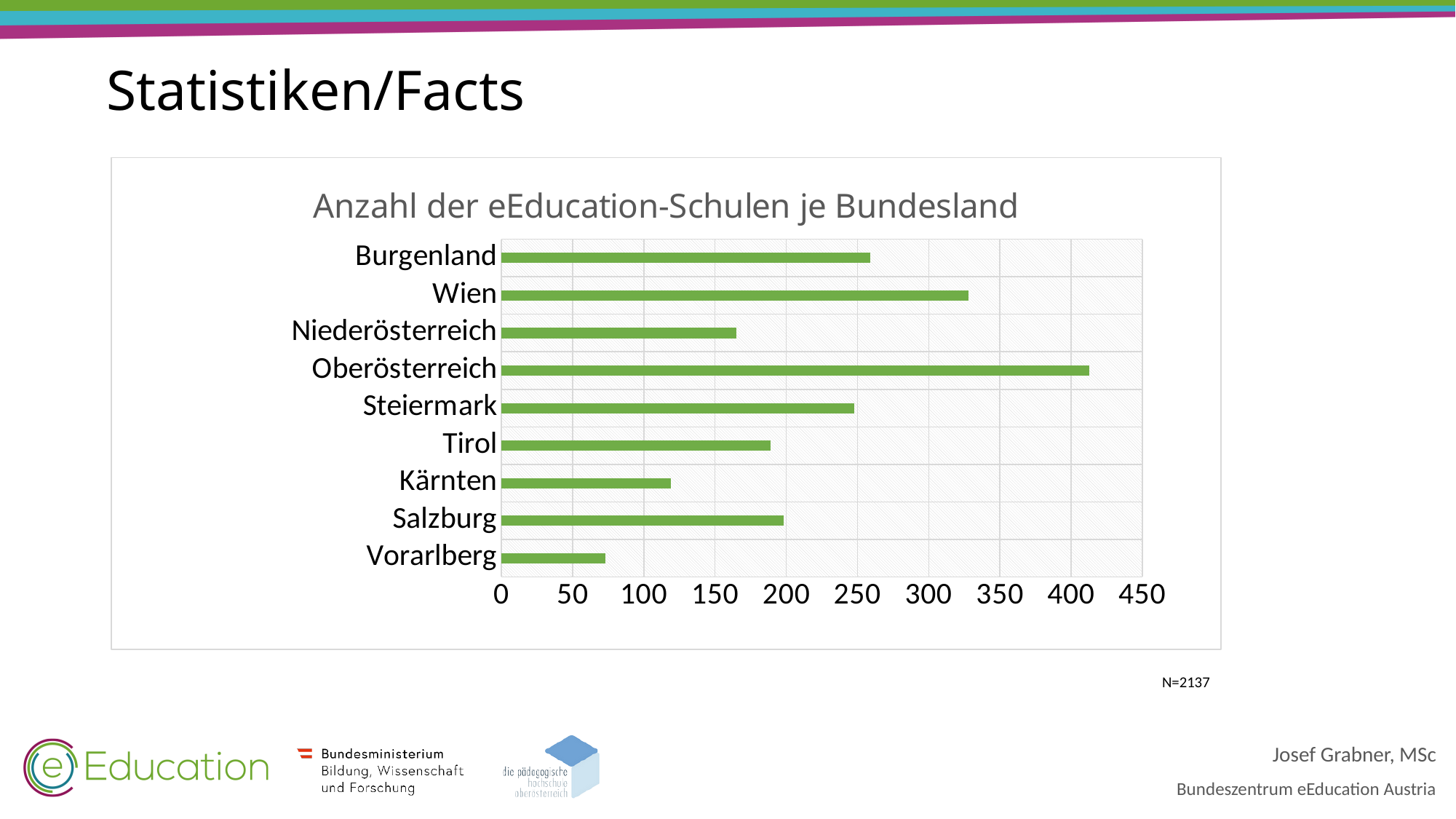
Is the value for Kärnten greater or less than 100? greater Which Bundesland has the lowest number of eEducation-Schulen? Vorarlberg Is the value for Wien greater or less than 300? greater Which has more eEducation-Schulen, Wien or Burgenland? Wien Is the value for Oberösterreich greater or less than 350? greater Which has more eEducation-Schulen, Kärnten or Tirol? Tirol What type of chart is shown on the slide? bar chart Which Bundesland has the highest number of eEducation-Schulen? Oberösterreich How many Bundesländer (categories) are shown in the chart? 9 What is the title of the chart? Anzahl der eEducation-Schulen je Bundesland